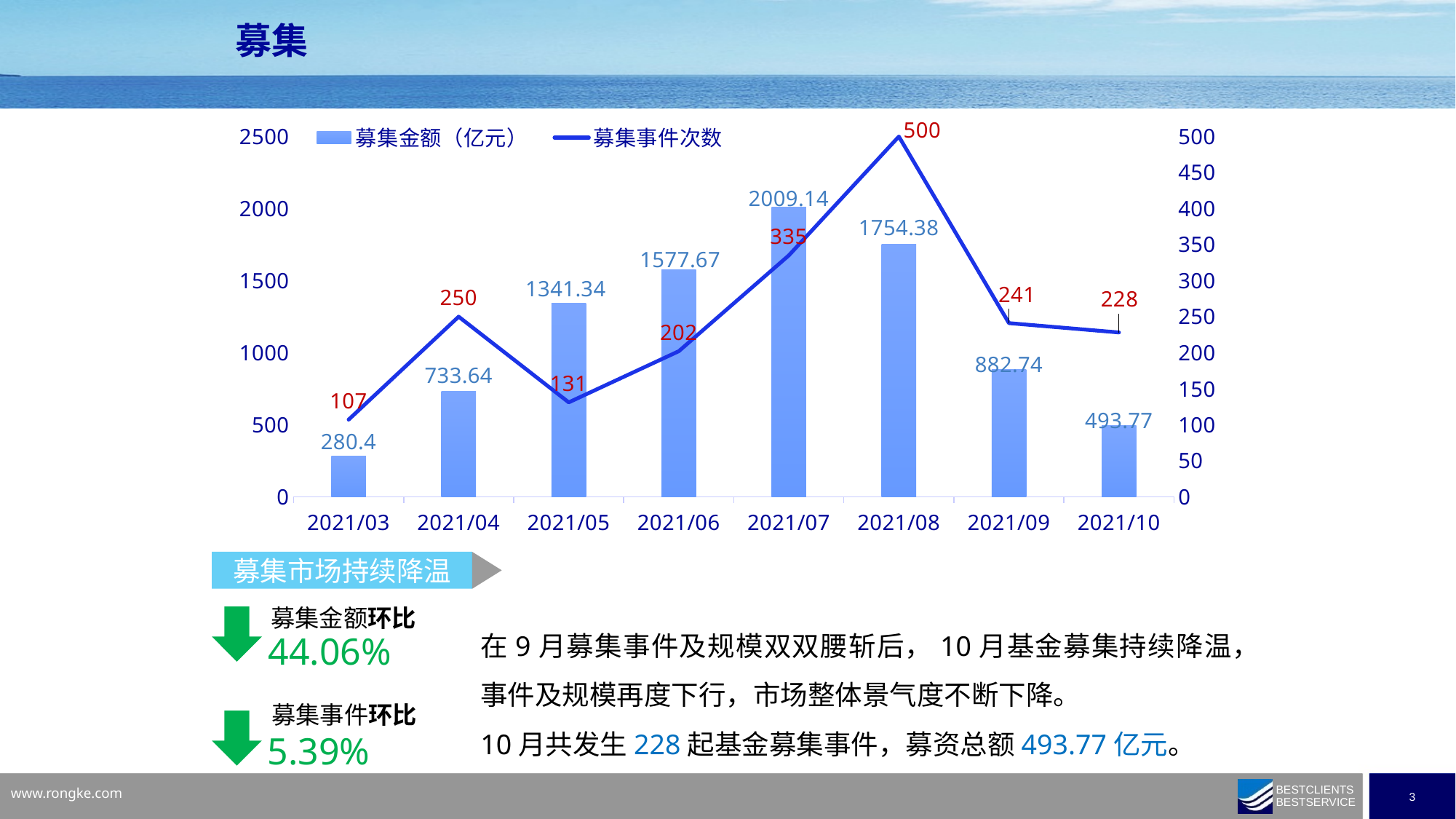
Which month has the lowest 募集事件次数? 2021/03 Which month has the highest 募集金额（亿元）? 2021/07 Does the 募集金额（亿元） rise or fall from 2021/08 to 2021/10? fall What is the 募集事件次数 value for 2021/08? 500 How many series does the chart legend list? 2 Which is larger, the 募集金额（亿元） for 2021/05 or for 2021/09? 2021/05 What is the 募集金额（亿元） value for 2021/10? 493.77 What is the difference in 募集事件次数 between 2021/09 and 2021/10? 13 Which series is drawn as a line in the chart? 募集事件次数 What is the 募集金额（亿元） value for 2021/07? 2009.14 What is the difference in 募集金额（亿元） between 2021/07 and 2021/08? 254.76 How many months are shown on the x axis of the chart? 8